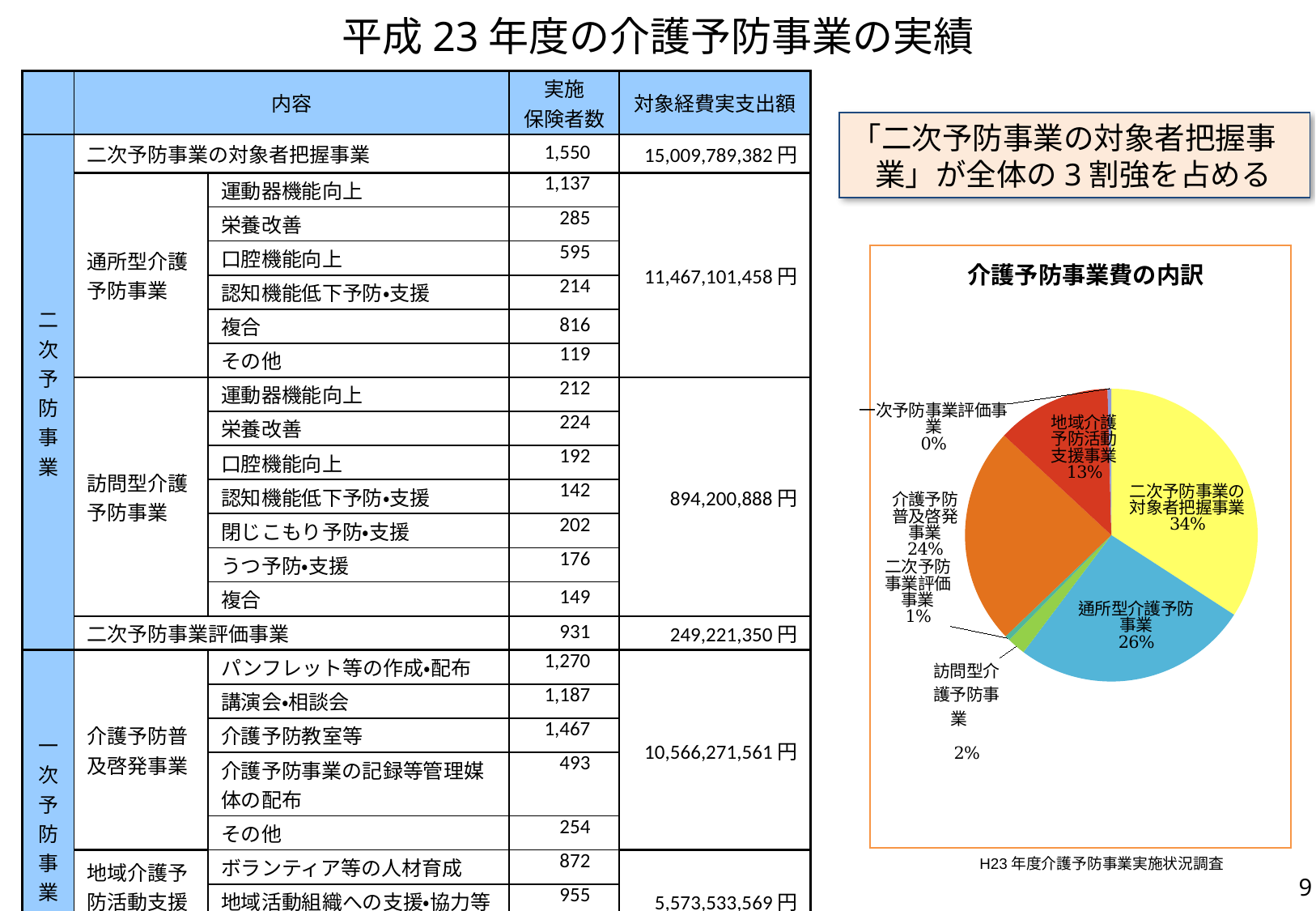
Which has the larger share, 通所型介護予防事業 or 介護予防普及啓発事業? 通所型介護予防事業 What share of the pie does 介護予防普及啓発事業 account for? 24% Which category has the largest share of the pie? 二次予防事業の対象者把握事業 Which category has the smallest share of the pie? 一次予防事業評価事業 What kind of chart is shown on the slide? pie chart How many categories are shown in the pie chart? 7 What share of the pie does 訪問型介護予防事業 account for? 2% What share of the pie does 地域介護予防活動支援事業 account for? 13% What is the title of the chart on the slide? 介護予防事業費の内訳 What is the difference in percentage points between the shares of 二次予防事業の対象者把握事業 and 地域介護予防活動支援事業? 21 percentage points